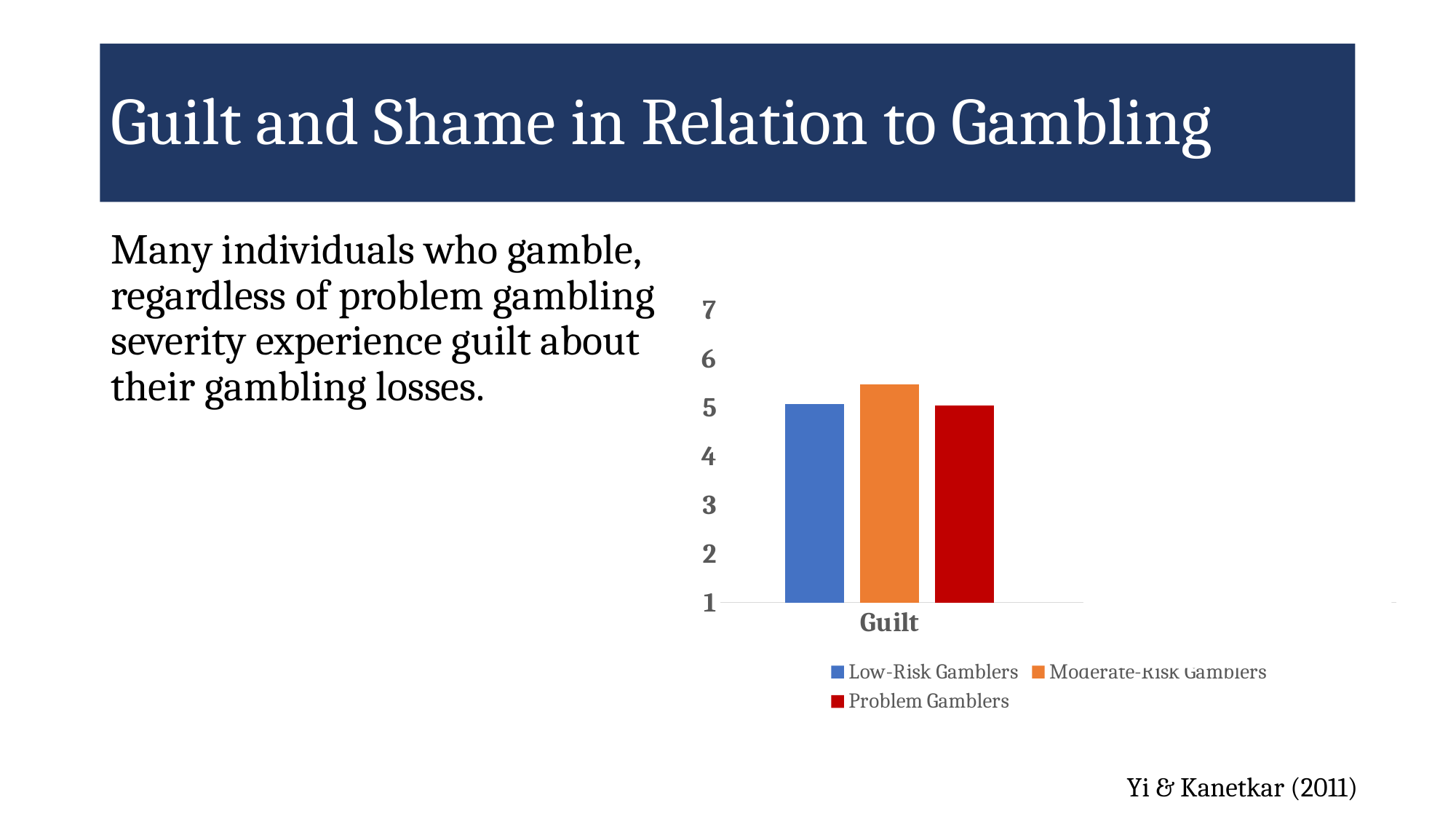
Which series has the highest bar for Guilt? Moderate-Risk Gamblers Is the Guilt value for Low-Risk Gamblers greater or less than 4? greater How many categories are shown on the x axis of the chart? 1 Is the Guilt value for Moderate-Risk Gamblers greater or less than 5? greater What colour is the bar for Problem Gamblers? dark red Is the Guilt value for Low-Risk Gamblers greater or less than 6? less Which is larger for Guilt: the value for Moderate-Risk Gamblers or the value for Problem Gamblers? Moderate-Risk Gamblers How many series does the chart's legend list? 3 What is the category label shown on the x axis of the chart? Guilt What kind of chart is shown on the slide? bar chart